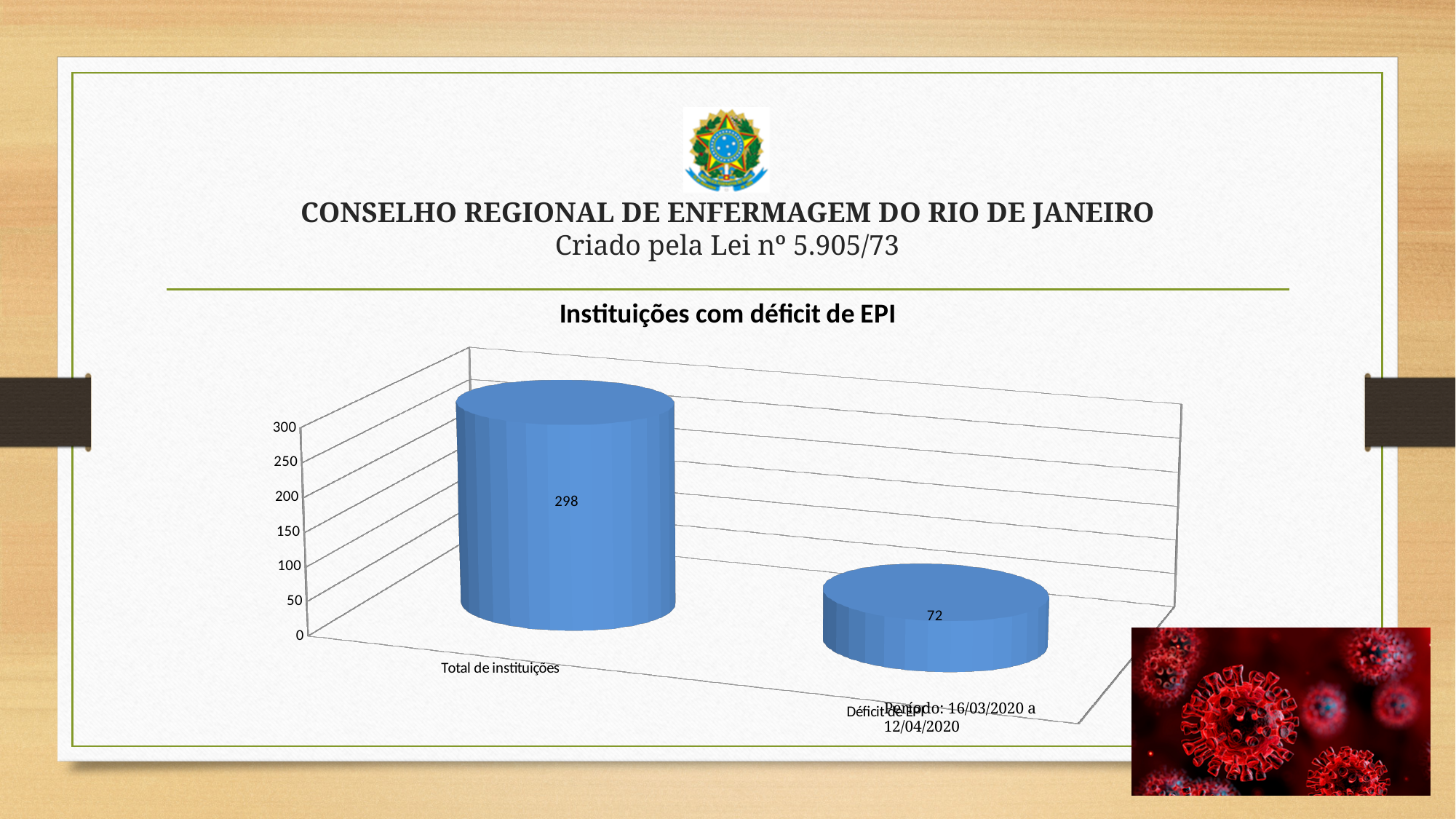
Which category has the lowest value in the chart? Déficit de EPI What kind of chart is shown on the slide? Bar chart What is the difference between the value for Total de instituições and the value for Déficit de EPI? 226 Is the value for Déficit de EPI greater or less than 100? less How many categories are shown in the chart? 2 What is the highest value shown on the vertical axis of the chart? 300 Which is larger, the value for Total de instituições or the value for Déficit de EPI? Total de instituições What is the value for Déficit de EPI in the chart? 72 Is the value for Total de instituições greater or less than 250? greater Which category has the highest value in the chart? Total de instituições What is the value for Total de instituições in the chart? 298 What is the title of the chart? Instituições com déficit de EPI